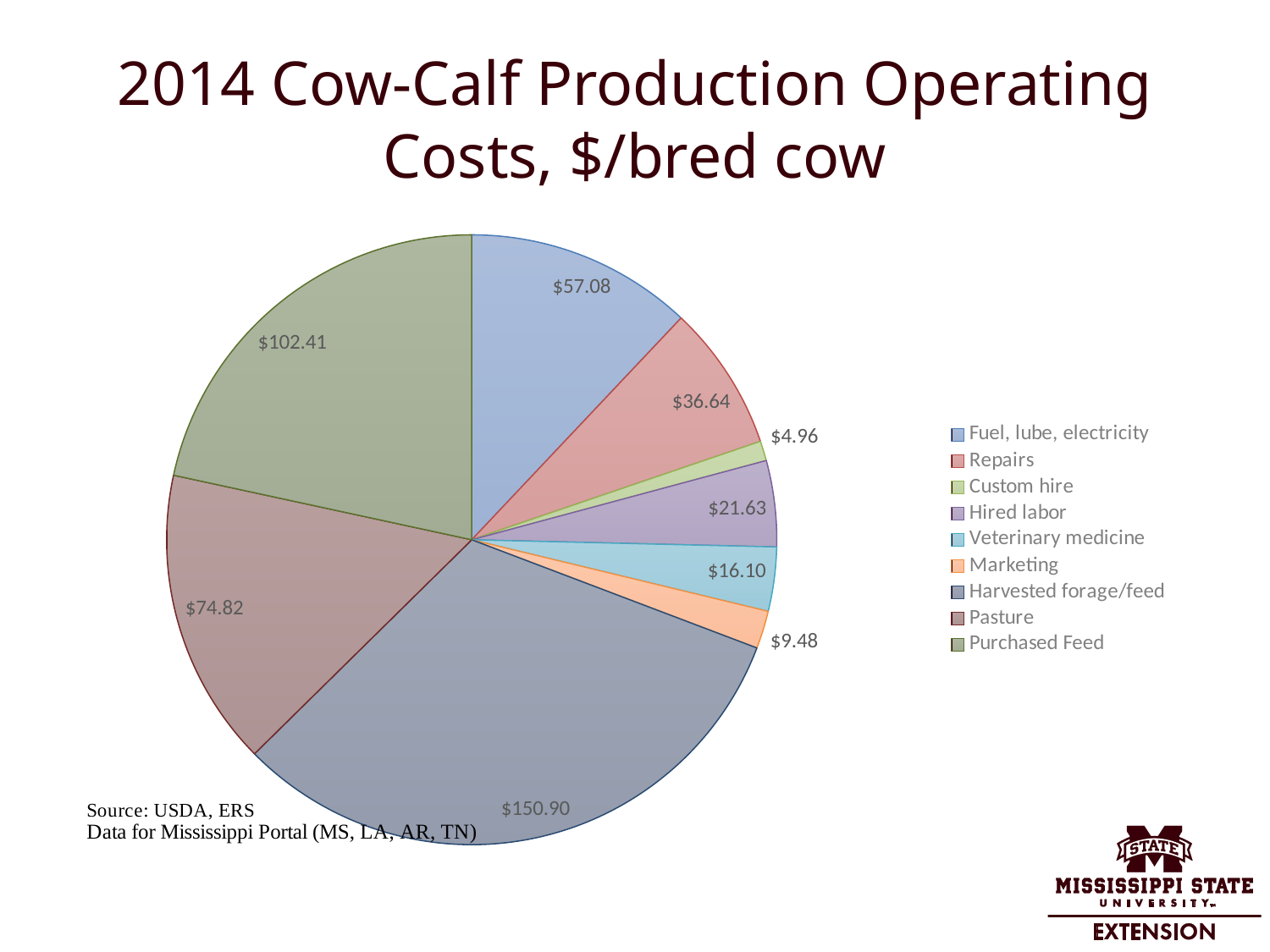
Which category has the smallest operating cost? Custom hire What type of chart is shown on the slide? Pie chart What is the operating cost for Fuel, lube, electricity? $57.08 Which is larger, the cost for Repairs or the cost for Hired labor? Repairs What is the operating cost for Veterinary medicine? $16.10 What is the operating cost for Pasture? $74.82 How many categories are shown in the pie chart? 9 What is the operating cost for Harvested forage/feed? $150.90 What is the difference between the Harvested forage/feed cost and the Purchased Feed cost? $48.49 What is the source of the data cited on the slide? USDA, ERS What is the total of all operating cost categories shown in the pie chart? $474.02 Which category has the largest operating cost? Harvested forage/feed